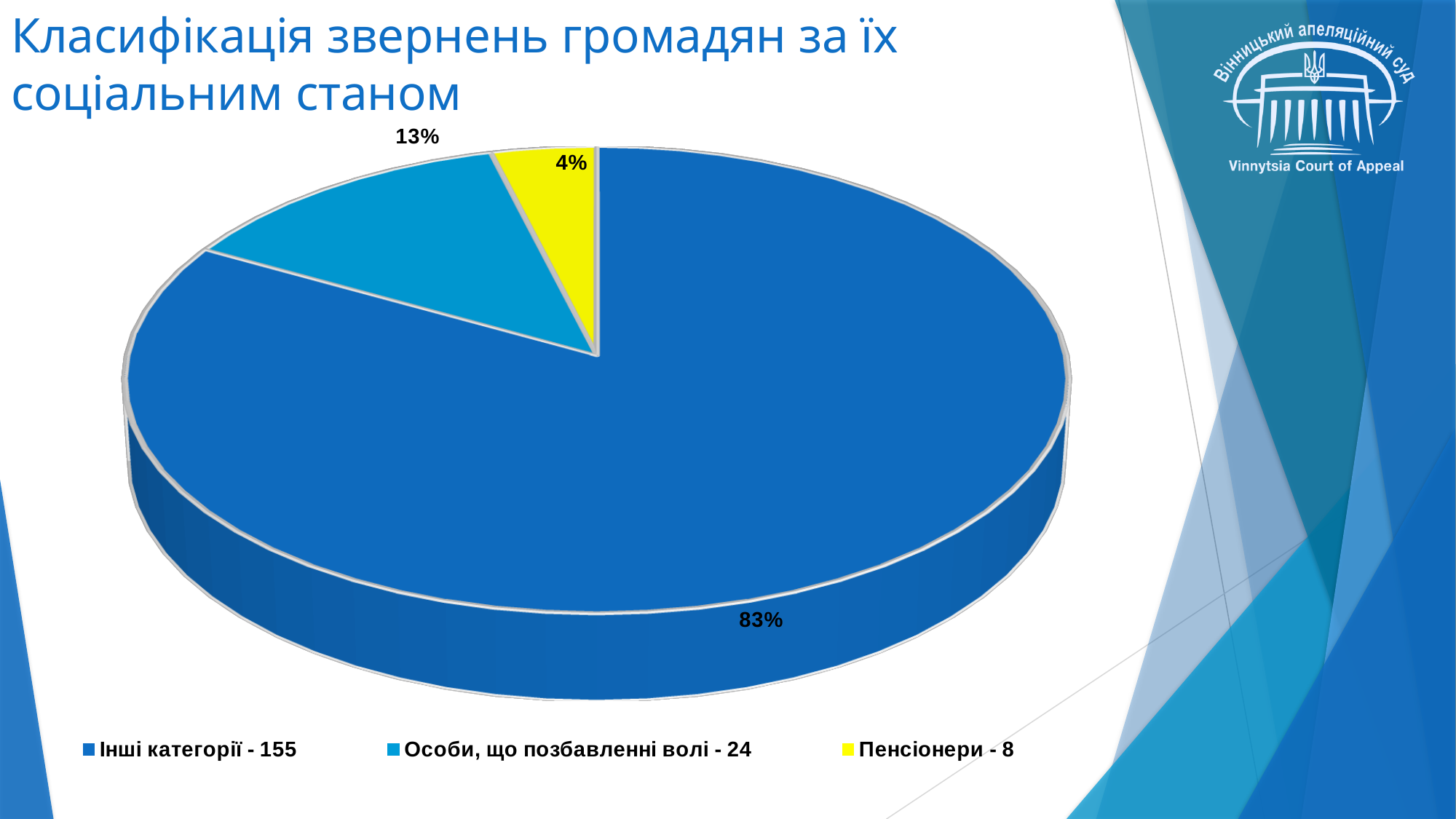
Which is larger: the slice for "Особи, що позбавленні волі" or the slice for "Пенсіонери"? Особи, що позбавленні волі What share of the pie does the slice for "Інші категорії" represent? 83% What is the difference in percentage points between the "Інші категорії" slice and the "Особи, що позбавленні волі" slice? 70 percentage points What share of the pie does the slice for "Пенсіонери" represent? 4% According to the legend, how many appeals fall under "Інші категорії"? 155 According to the legend, how many appeals fall under "Пенсіонери"? 8 What type of chart is shown on the slide? Pie chart How many categories are shown in the pie chart? 3 Which category has the smallest slice of the pie? Пенсіонери What share of the pie does the slice for "Особи, що позбавленні волі" represent? 13% According to the legend, how many appeals fall under "Особи, що позбавленні волі"? 24 Which category has the largest slice of the pie? Інші категорії